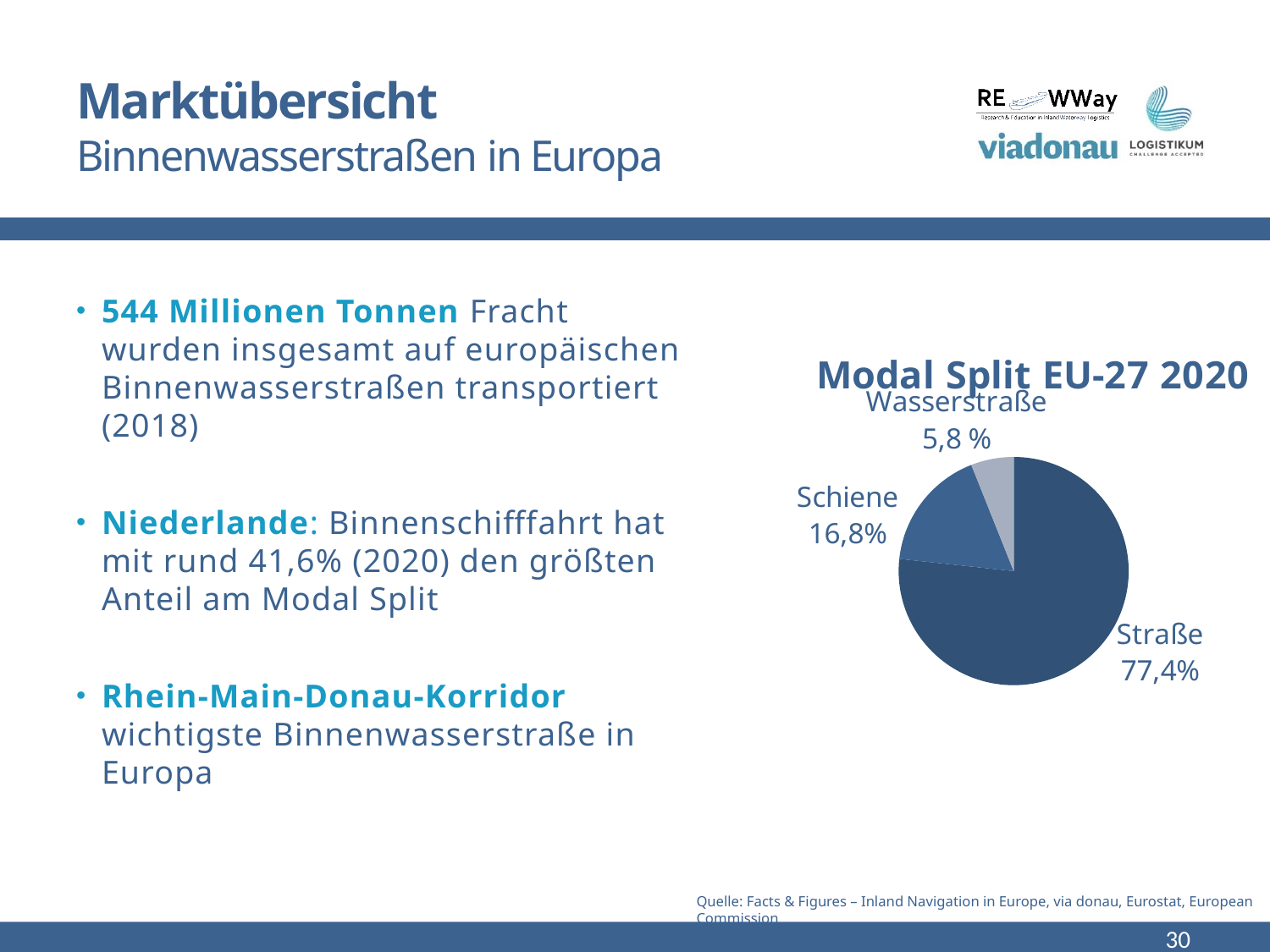
Which category is shown in the lightest grey-blue colour in the pie chart? Wasserstraße What is the difference in percentage points between Schiene and Wasserstraße? 11,0 What is the title of the chart? Modal Split EU-27 2020 What is the difference in percentage points between Straße and Schiene? 60,6 Which category has the largest slice in the pie chart? Straße What share of the pie chart does Wasserstraße have? 5,8 % What share of the pie chart does Schiene have? 16,8% What kind of chart is shown on the slide? Pie chart Which is larger, the share for Schiene or the share for Wasserstraße? Schiene How many categories are shown in the pie chart? 3 What share of the pie chart does Straße have? 77,4% Which category has the smallest slice in the pie chart? Wasserstraße